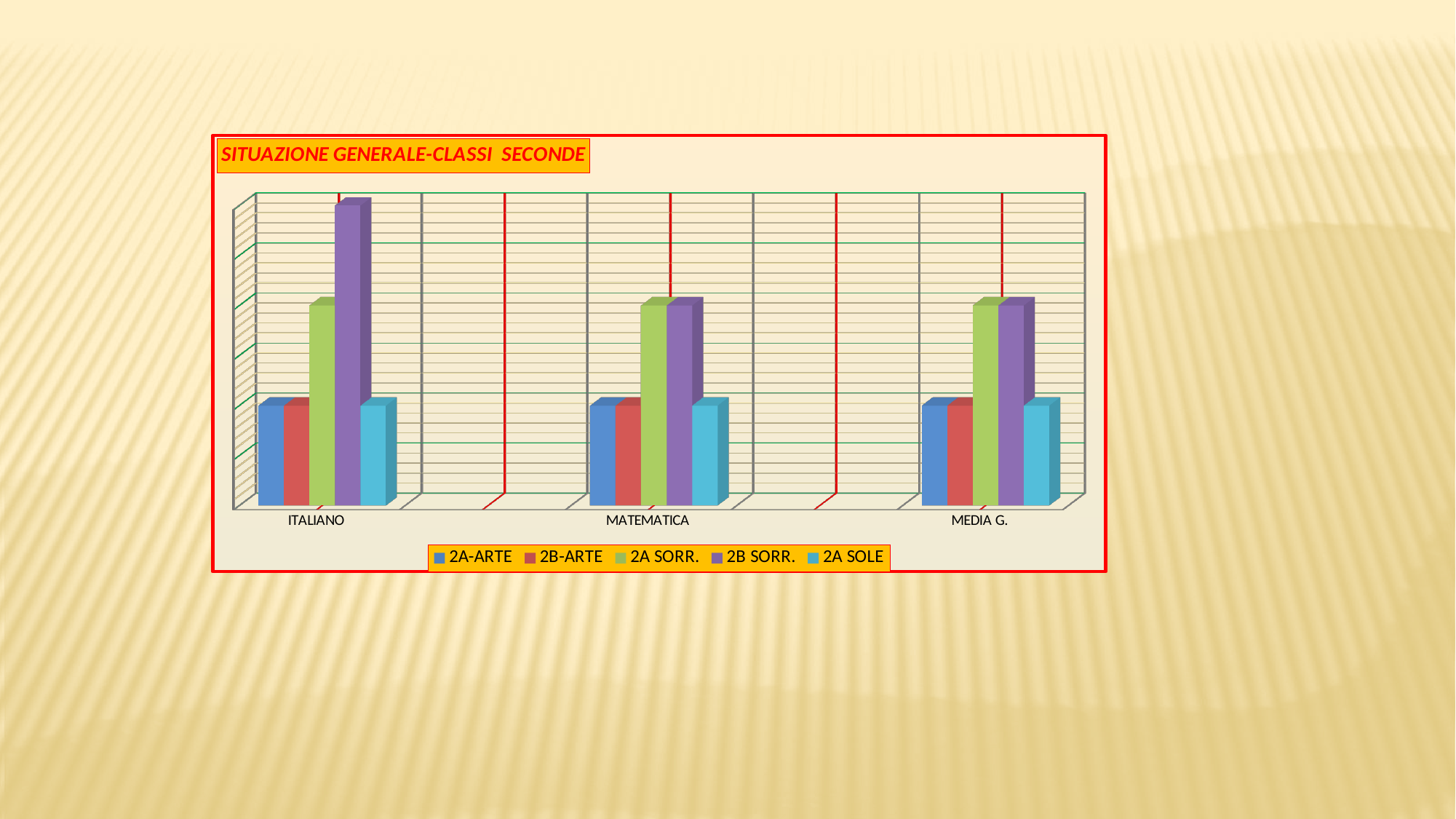
What is the title of the chart? SITUAZIONE GENERALE-CLASSI SECONDE In the ITALIANO category, which is larger: the value for 2B SORR. or the value for 2A SORR.? 2B SORR. In the MEDIA G. category, which is larger: the value for 2B SORR. or the value for 2B-ARTE? 2B SORR. In the MATEMATICA category, which is larger: the value for 2A SORR. or the value for 2A SOLE? 2A SORR. Which series has the highest value in the ITALIANO category? 2B SORR. How many categories are shown on the x axis of the chart? 3 Does the value for 2B SORR. rise or fall from ITALIANO to MATEMATICA? fall Which series is represented by the purple bars in the chart? 2B SORR. How many series does the chart's legend list? 5 In which category does the 2B SORR. series reach its highest value? ITALIANO What kind of chart is shown on the slide? bar chart